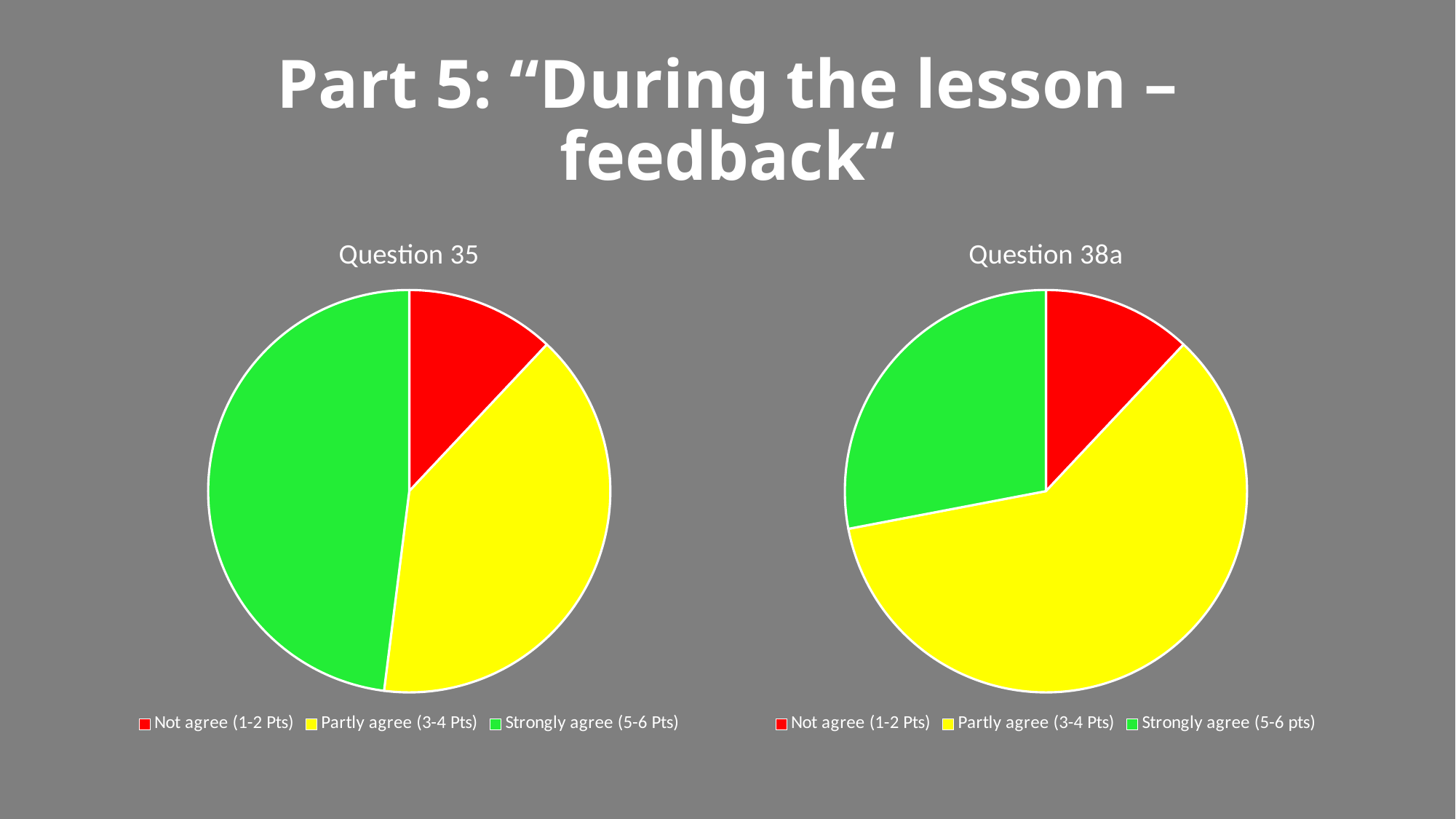
In the "Question 38a" chart, which slice is larger: Partly agree (3-4 Pts) or Strongly agree (5-6 pts)? Partly agree (3-4 Pts) In the "Question 35" chart, which category has the smallest slice? Not agree (1-2 Pts) In the "Question 35" chart, what colour represents Not agree (1-2 Pts)? red In the "Question 38a" chart, which category has the largest slice? Partly agree (3-4 Pts) In the "Question 35" chart, how many slices does the pie have? 3 In the "Question 35" chart, which slice is larger: Strongly agree (5-6 Pts) or Partly agree (3-4 Pts)? Strongly agree (5-6 Pts) What kind of chart is the "Question 35" chart? pie chart In the "Question 38a" chart, which category has the smallest slice? Not agree (1-2 Pts) In the "Question 38a" chart, how many categories does the legend list? 3 What is the title of the slide? Part 5: "During the lesson – feedback" What kind of chart is the "Question 38a" chart? pie chart In the "Question 35" chart, which category has the largest slice? Strongly agree (5-6 Pts)